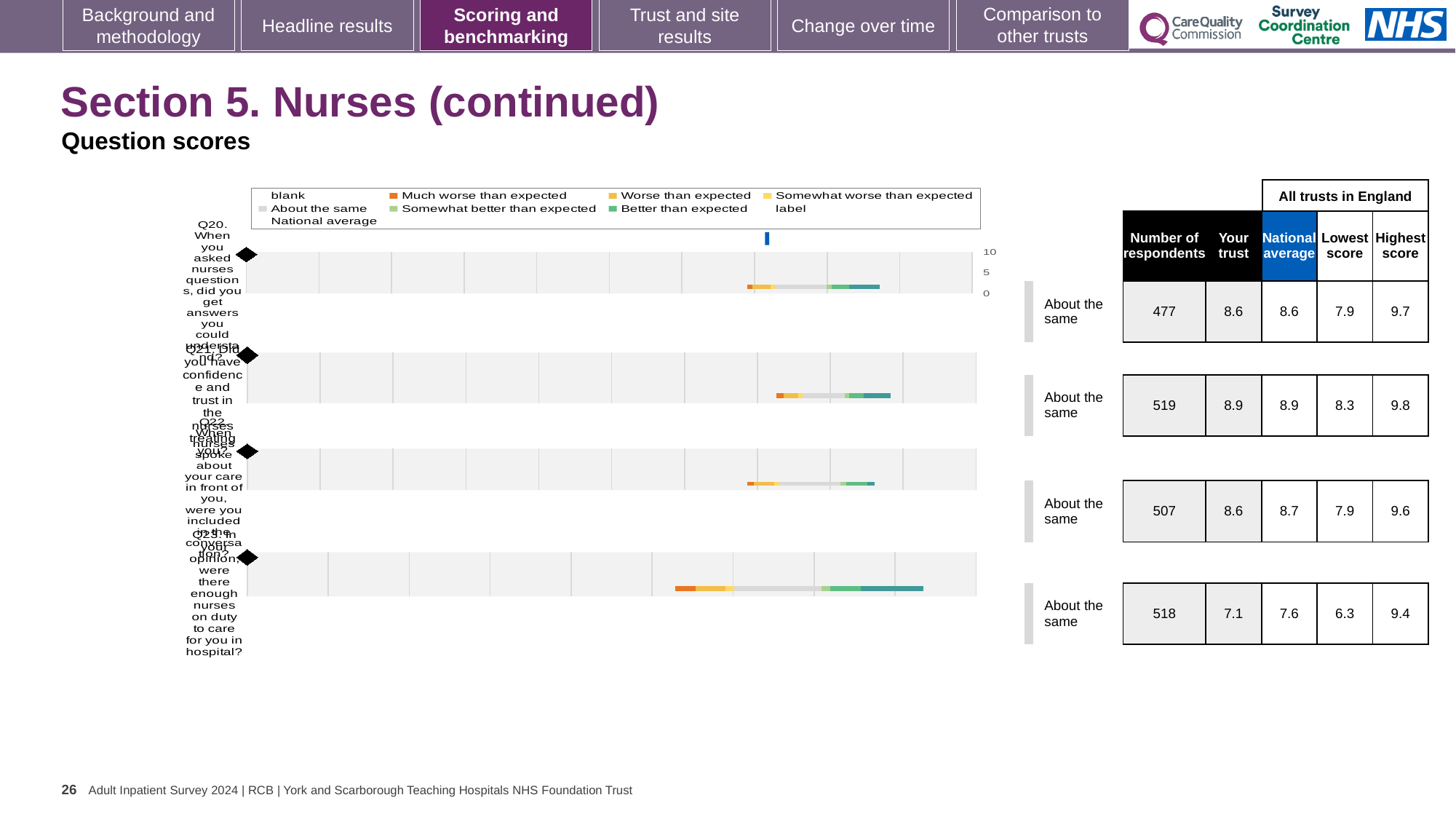
What benchmark category is shown for Q23? About the same What is the national average score for Q22 (were you included in the conversation)? 8.7 What kind of chart is shown on the slide? bar chart What is the 'Your trust' score for Q23 (were there enough nurses on duty)? 7.1 How many respondents answered Q21 (confidence and trust in nurses)? 519 What is the highest score among all trusts in England for Q21? 9.8 How many questions (categories) are plotted in the chart? 4 Which question has the lowest 'Your trust' score? Q23 For Q23, what is the difference between the national average and the 'Your trust' score? 0.5 Which question has the highest 'Your trust' score? Q21 Which has the larger 'Your trust' score, Q20 or Q23? Q20 What colour does the legend use for 'Much worse than expected'? orange